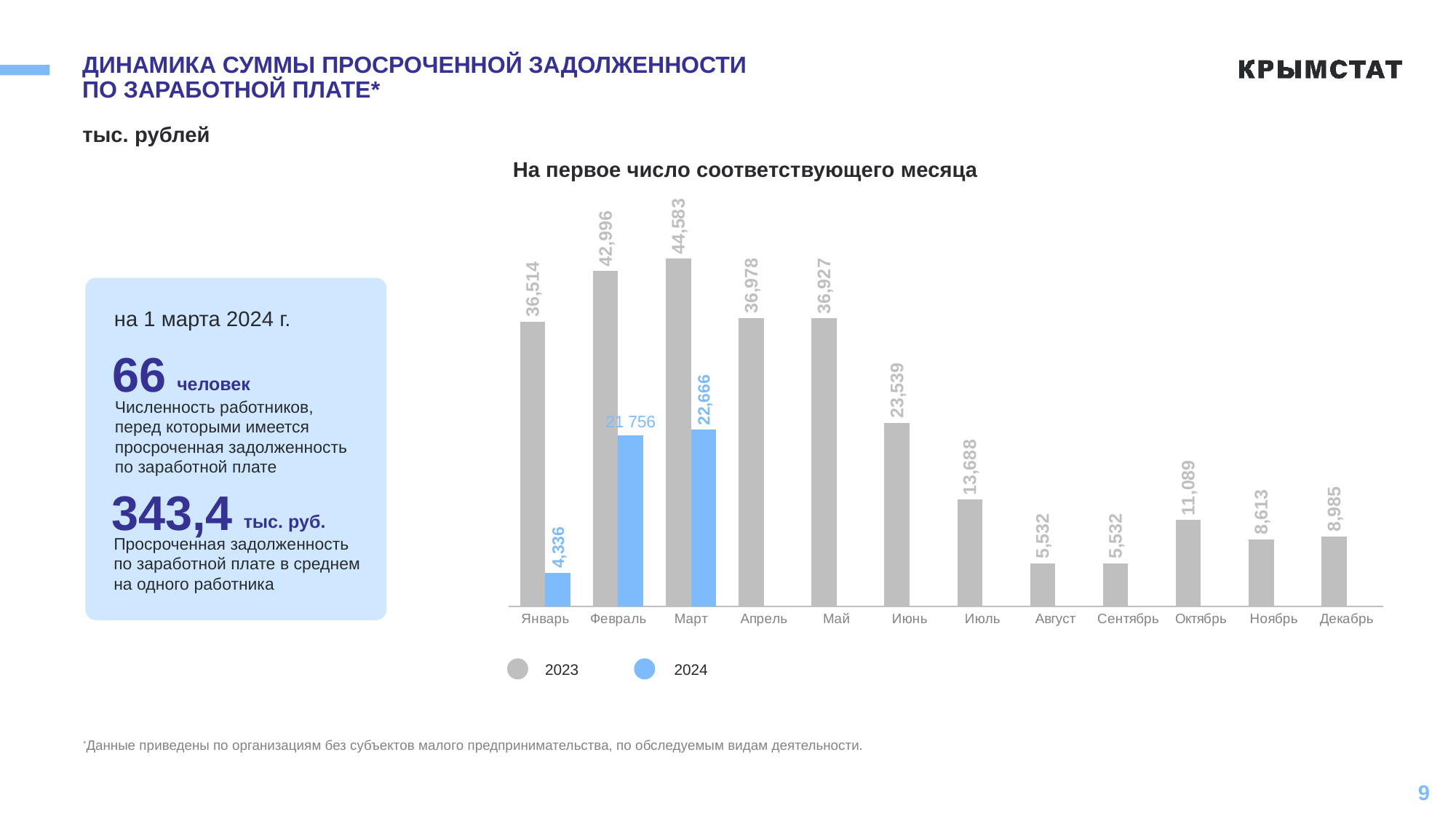
What is the value for Февраль in the 2024 series? 21 756 What colour are the bars for the 2024 series? Blue Which month has the highest value in the 2023 series? Март How many months are shown on the x axis? 12 Which month has the lowest value in the 2024 series? Январь Do the 2023 values rise or fall from Май to Сентябрь? Fall What is the value for Январь in the 2024 series? 4,336 What kind of chart is shown on the slide? Bar chart Which is larger: the 2023 value for Июнь or the 2023 value for Июль? Июнь How many series does the legend list? 2 What is the value for Март in the 2023 series? 44,583 What is the difference between the 2023 and 2024 values for Март? 21,917